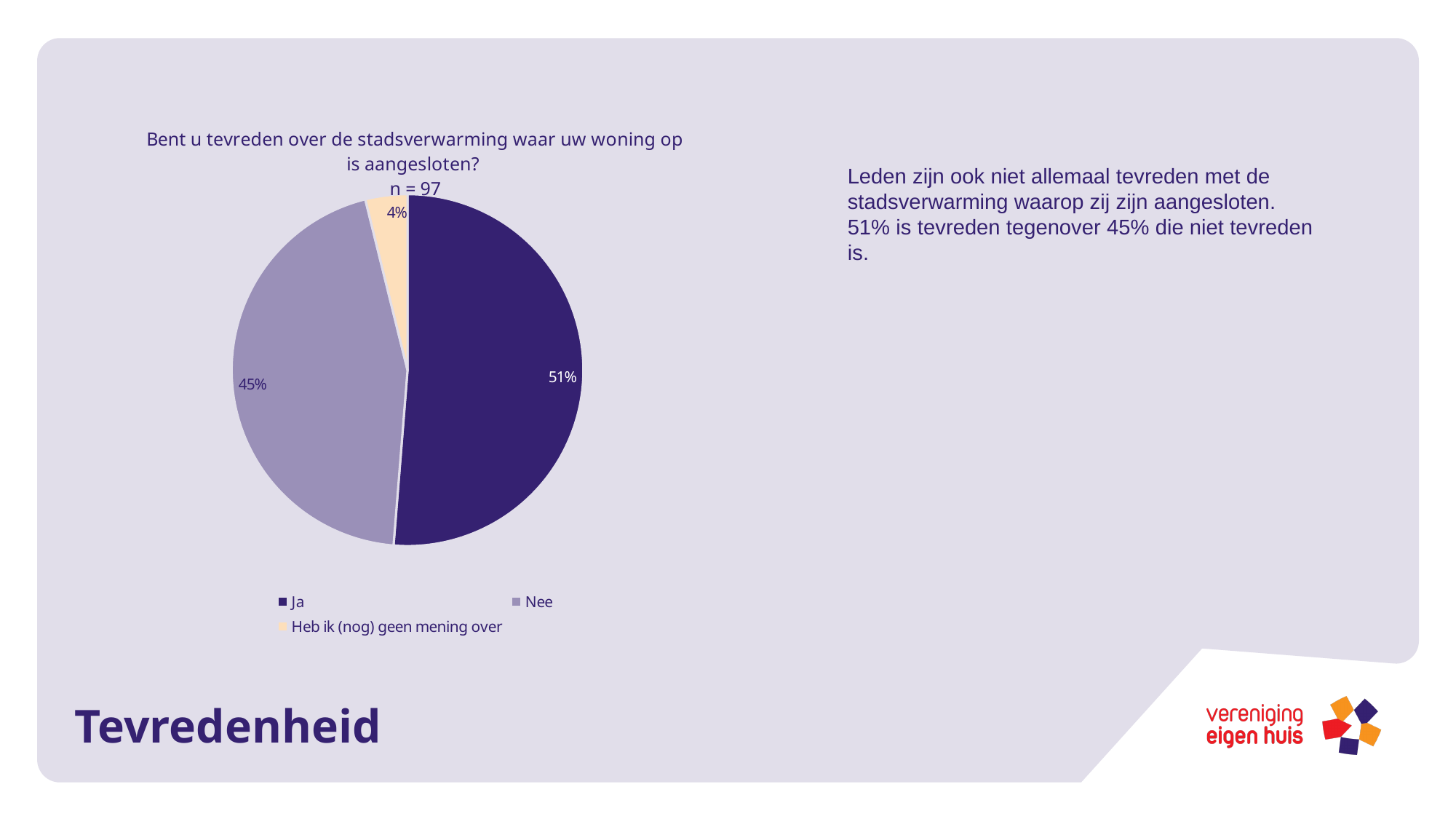
What colour is the "Ja" slice of the pie? dark purple Which category has the largest slice of the pie? Ja What is the difference in percentage points between the "Ja" and "Nee" slices? 6 What kind of chart is shown on the slide? pie chart How many slices does the pie chart have? 3 Which category has the smallest slice of the pie? Heb ik (nog) geen mening over How many entries does the legend list? 3 Which slice is larger, "Nee" or "Heb ik (nog) geen mening over"? Nee What sample size (n) is stated in the chart title? n = 97 What share of the pie is labelled "Nee"? 45% What share of the pie is labelled "Heb ik (nog) geen mening over"? 4% What share of the pie is labelled "Ja"? 51%